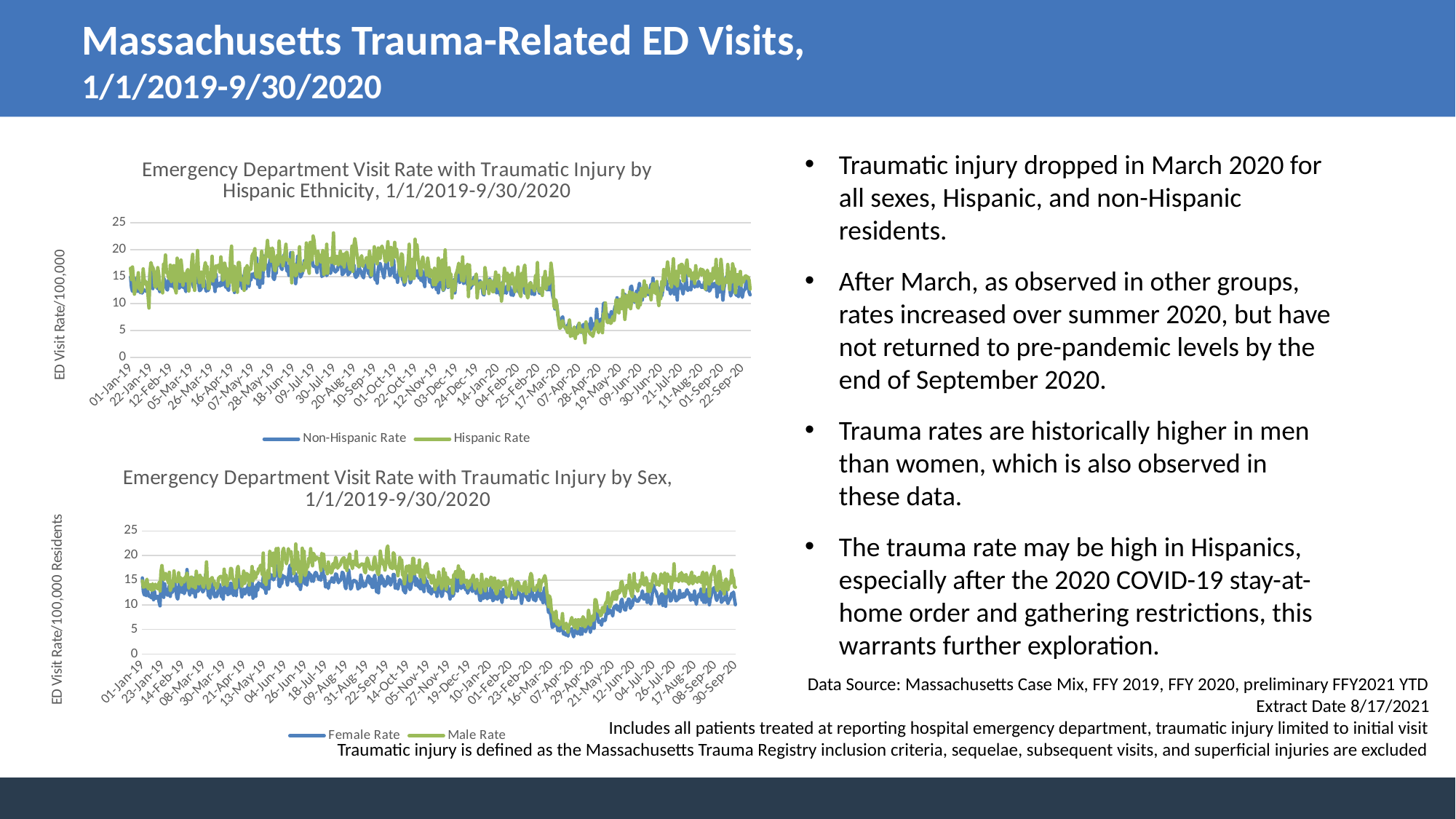
In the bottom chart (by Sex), do the rates rise or fall between 07-Apr-20 and 26-Jul-20? Rise In the bottom chart (by Sex), what is the label on the vertical axis? ED Visit Rate/100,000 Residents How many series does the legend of the bottom chart (by Sex) list? 2 In the bottom chart (by Sex), which series is higher around 26-Jun-19, the Male Rate or the Female Rate? Male Rate In the top chart (by Hispanic Ethnicity), is the Hispanic Rate around 07-Apr-20 greater or less than 10? less In the bottom chart (by Sex), is the Female Rate around 07-Apr-20 greater or less than 10? less What kind of chart is the bottom chart, 'Emergency Department Visit Rate with Traumatic Injury by Sex'? Line chart In the top chart (by Hispanic Ethnicity), what are the two series named in the legend? Non-Hispanic Rate and Hispanic Rate In the top chart (by Hispanic Ethnicity), do the rates rise or fall between 25-Feb-20 and 07-Apr-20? Fall How many series does the legend of the top chart (by Hispanic Ethnicity) list? 2 What kind of chart is the top chart, 'Emergency Department Visit Rate with Traumatic Injury by Hispanic Ethnicity'? Line chart In the bottom chart (by Sex), is the Male Rate around 26-Jun-19 greater or less than 15? greater